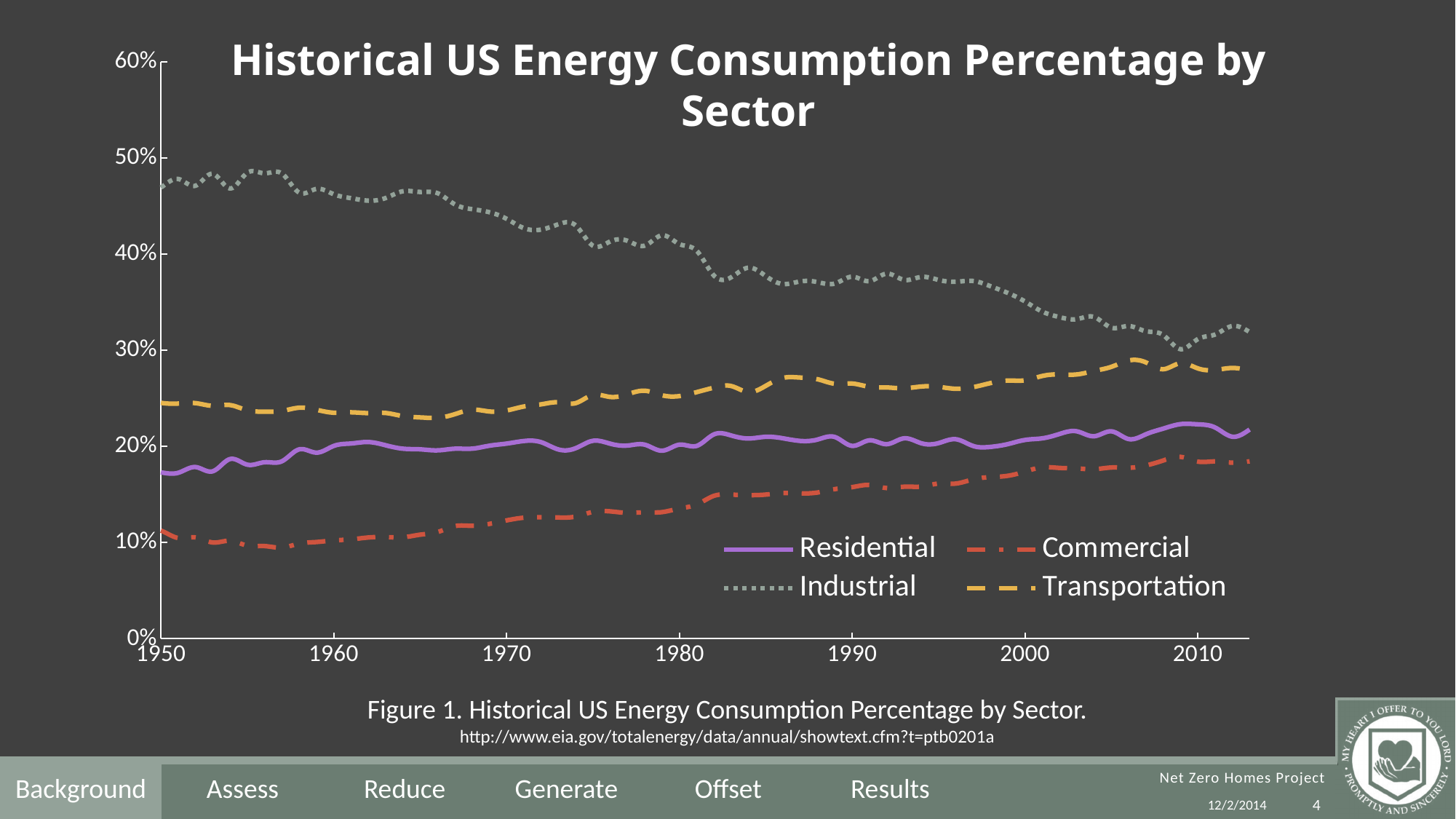
Does the Industrial series rise or fall from 1950 to 2010? fall What kind of chart is shown on the slide? line chart Is the value for Commercial in 1950 greater or less than 20%? less Is the value for Industrial in 1950 greater or less than 40%? greater Which series is drawn with a solid purple line? Residential Which sector has the lowest energy consumption percentage in 1950? Commercial How many series does the legend list? 4 Is the value for Transportation in 2010 greater or less than 30%? less Which sector has the highest energy consumption percentage in 1950? Industrial In 2000, which is larger: Transportation or Commercial? Transportation What is the title of the chart? Historical US Energy Consumption Percentage by Sector Does the Commercial series rise or fall from 1950 to 2010? rise